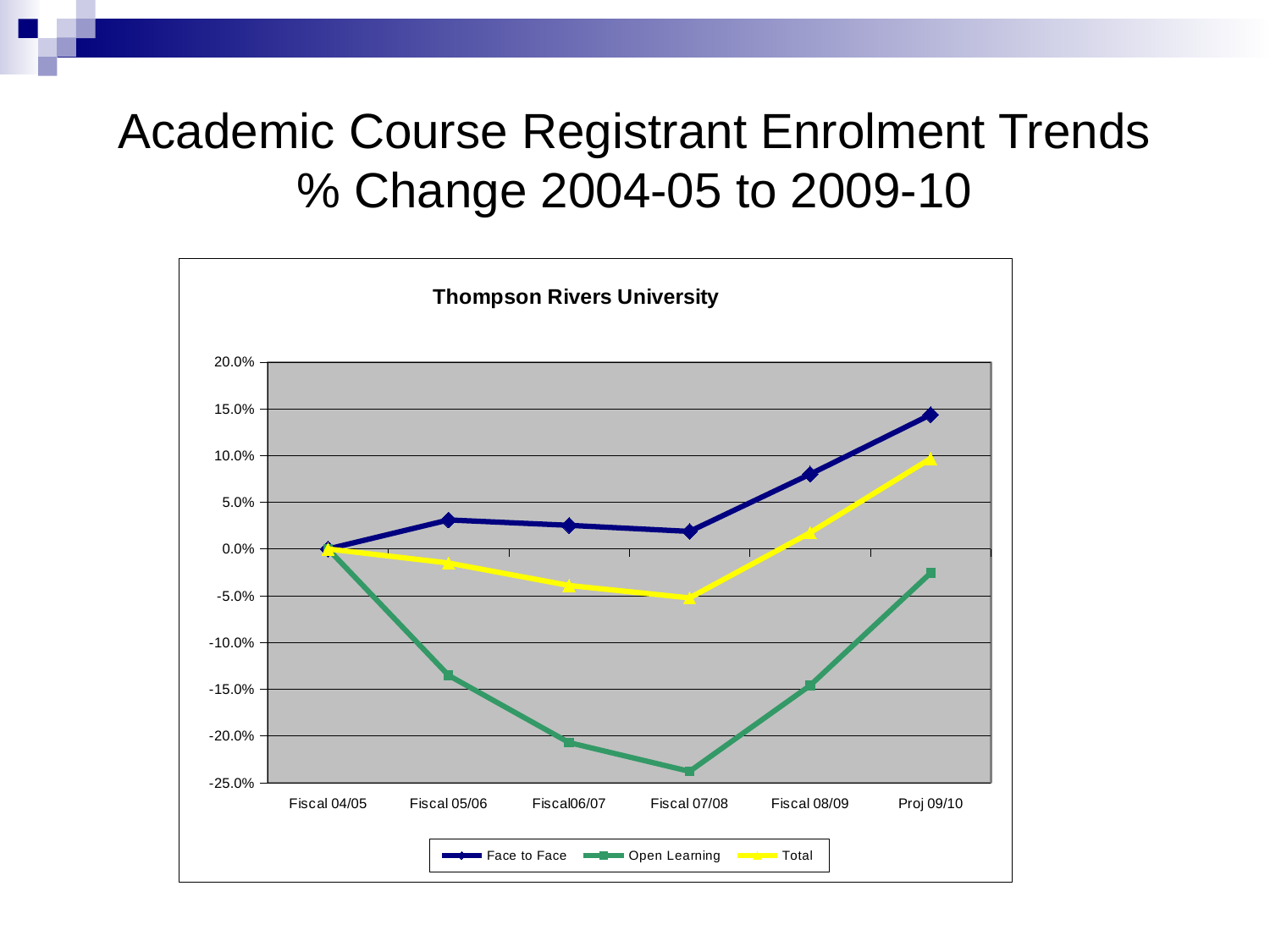
Is the value for Open Learning at Fiscal 07/08 greater or less than -20.0%? less What is the value for Open Learning at Fiscal 04/05? 0.0% Which is larger at Fiscal06/07, the Face to Face value or the Open Learning value? Face to Face At which fiscal period does the Face to Face series reach its highest value? Proj 09/10 Is the value for Face to Face at Proj 09/10 greater or less than 10.0%? greater Is the value for Face to Face at Fiscal 08/09 greater or less than 5.0%? greater Does the Open Learning series rise or fall from Fiscal 07/08 to Proj 09/10? rise What is the title printed inside the chart area? Thompson Rivers University How many series does the legend list? 3 What kind of chart is shown on the slide? line chart At which fiscal period does the Open Learning series reach its lowest value? Fiscal 07/08 How many fiscal periods are plotted along the x axis? 6